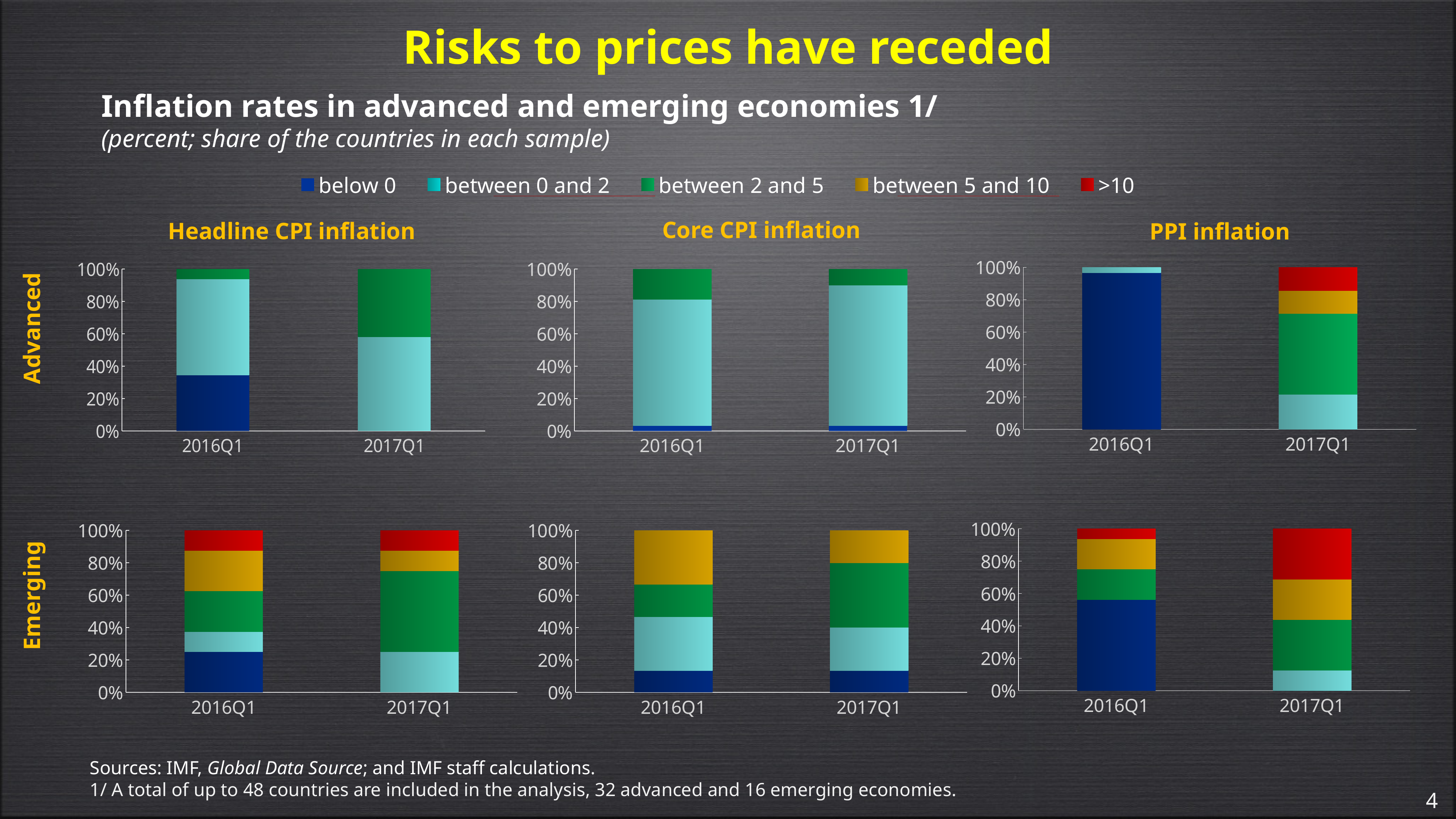
In the Advanced PPI inflation chart, which year has the larger 'below 0' share, 2016Q1 or 2017Q1? 2016Q1 In the Advanced Core CPI inflation chart, is the 'between 0 and 2' share for 2017Q1 greater or less than 60%? greater How many categories are shown on the x axis of the Emerging PPI inflation chart? 2 Which colour represents the '>10' series in the legend? red In the Advanced PPI inflation chart, is the 'below 0' share for 2016Q1 greater or less than 80%? greater In the Advanced Headline CPI inflation chart, does the 'below 0' share rise or fall from 2016Q1 to 2017Q1? fall In the Emerging PPI inflation chart, which year has the larger '>10' share, 2016Q1 or 2017Q1? 2017Q1 In the Emerging PPI inflation chart, is the '>10' share for 2017Q1 greater or less than 20%? greater How many series does the legend list? 5 What kind of chart is the Advanced Headline CPI inflation chart? stacked bar chart What is the title of the chart in the top right of the slide? PPI inflation